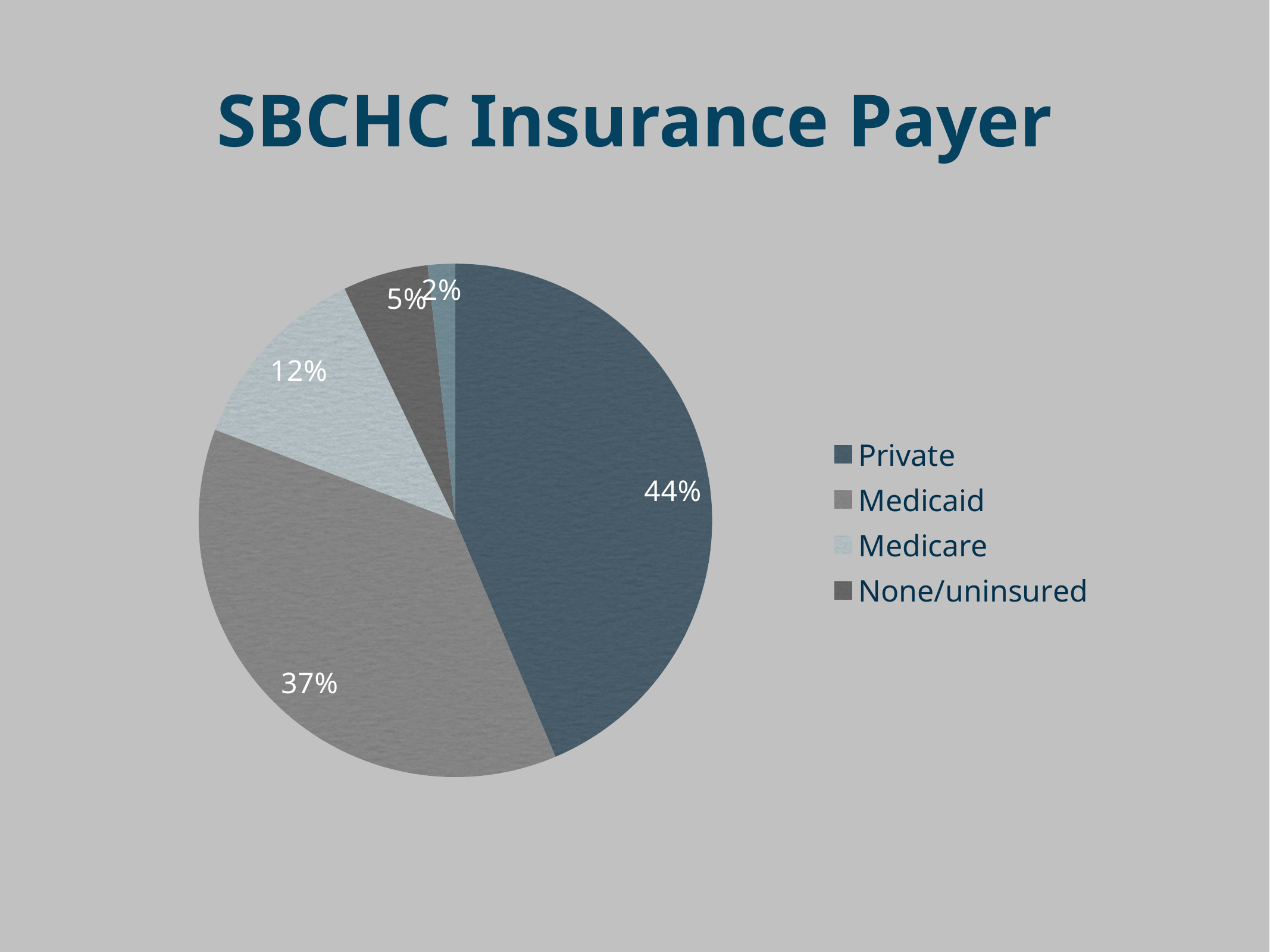
How many entries does the legend list? 4 What share of the pie does None/uninsured account for? 5% Which of the legend entries has the smallest share of the pie? None/uninsured Which is larger, the Medicare share or the None/uninsured share? Medicare What share of the pie does Medicaid account for? 37% What share of the pie does Private account for? 44% What is the difference in percentage points between the Private and Medicaid shares? 7 What kind of chart is shown on the slide? pie chart Which insurance payer has the largest share of the pie? Private How many slices does the pie chart have? 5 What is the title of the chart? SBCHC Insurance Payer